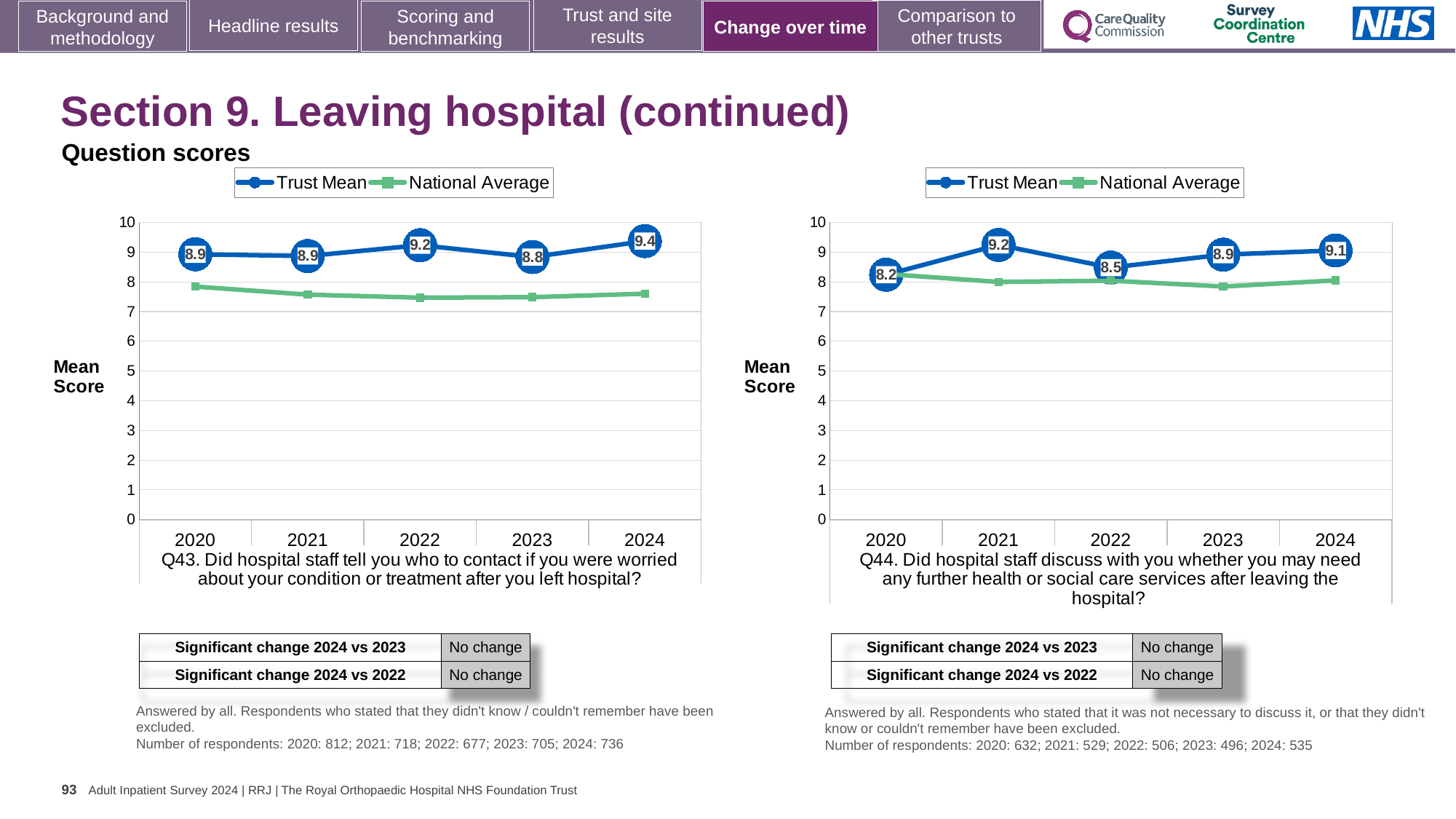
In the Q43 chart on the left, what is the label of the y axis? Mean Score In the Q43 chart on the left, what is the difference between the Trust Mean scores for 2024 and 2023? 0.6 In the Q43 chart on the left, what is the Trust Mean score for 2024? 9.4 In the Q44 chart on the right, which is larger: the Trust Mean score for 2022 or for 2023? 2023 In the Q43 chart on the left, which year has the highest Trust Mean score? 2024 In the Q44 chart on the right, what is the Trust Mean score for 2020? 8.2 What kind of chart is the Q43 chart on the left? Line chart In the Q43 chart on the left, is the National Average value for 2022 greater or less than 8? less In the Q44 chart on the right, what is the difference between the Trust Mean scores for 2021 and 2020? 1.0 How many years are shown on the x axis of the Q43 chart on the left? 5 How many series does the legend of the Q44 chart on the right list? 2 In the Q44 chart on the right, which year has the lowest Trust Mean score? 2020